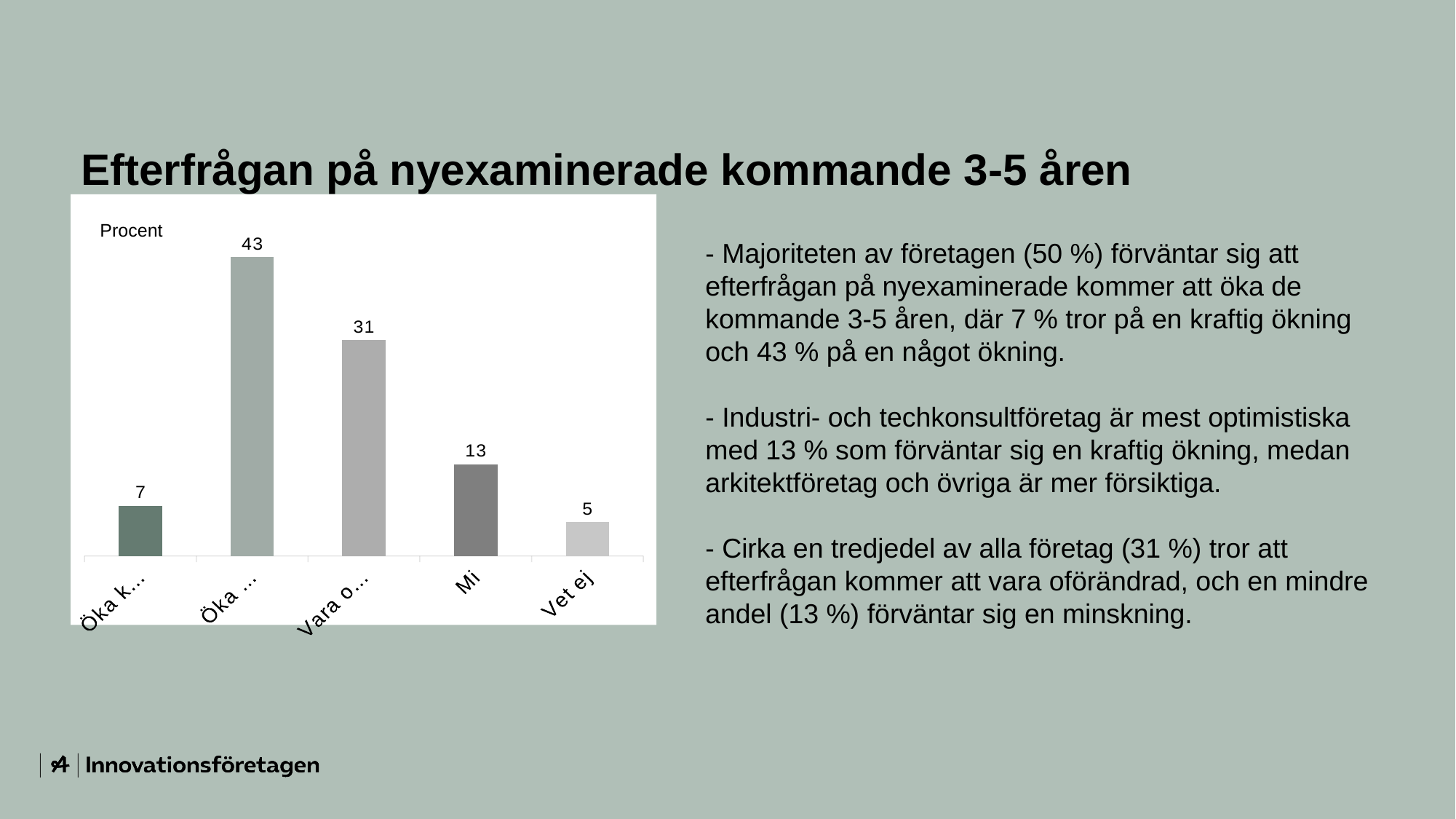
Which bar has the lowest value? Vet ej Which is larger, the first bar on the left or the bar labelled "Vet ej"? the first bar on the left What is the value of the bar labelled "Vet ej"? 5 What is the value of the fourth bar from the left? 13 Which bar has the highest value? the second bar (43) What kind of chart is shown on the slide? bar chart What is the value of the second bar from the left? 43 What is the difference between the second bar (43) and the third bar (31)? 12 What is the value of the third bar from the left? 31 What is the value of the first bar on the left? 7 What unit label is shown in the top-left corner of the chart? Procent How many bars does the chart show? 5